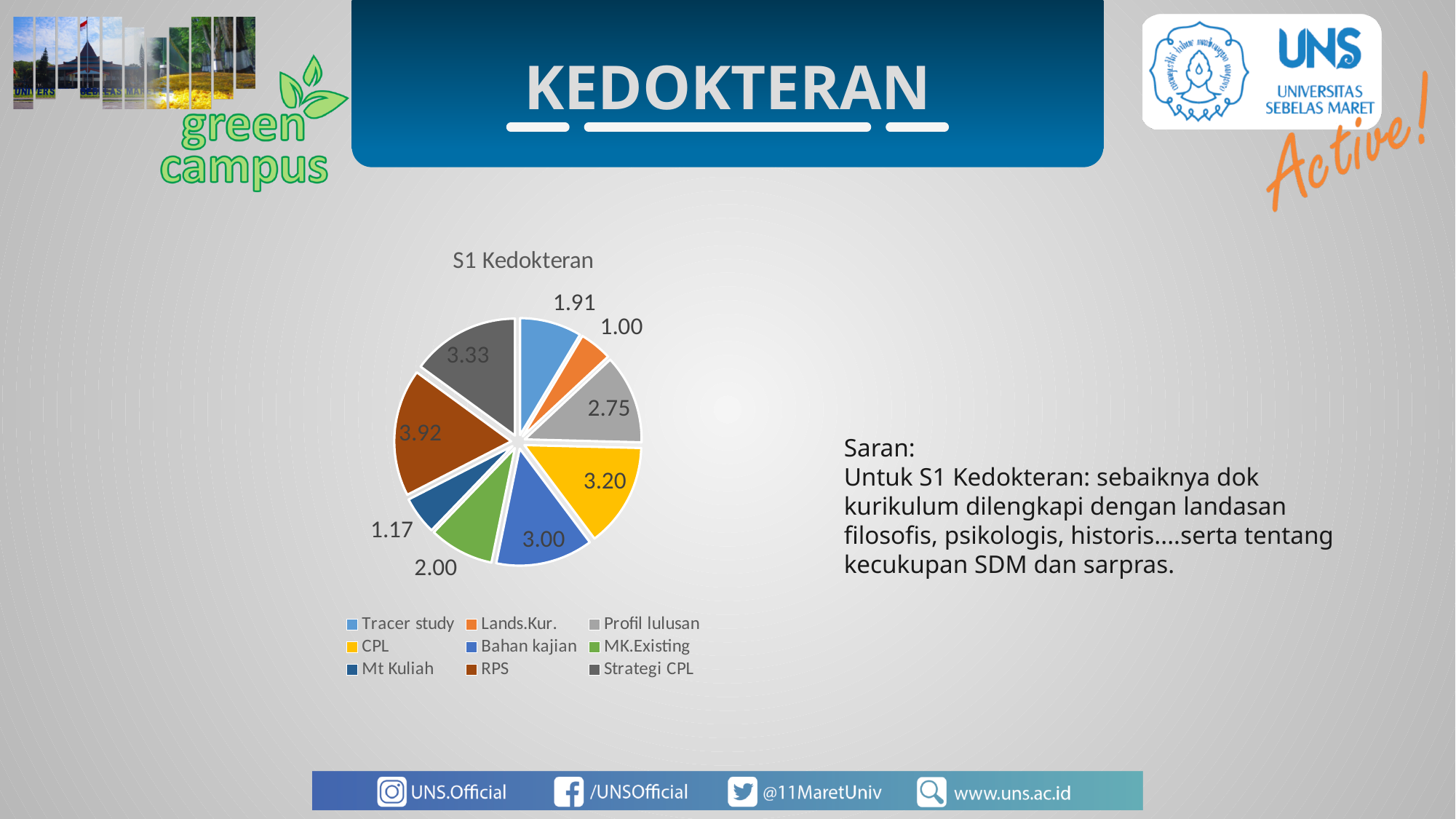
What is the value for Tracer study in the pie chart? 1.91 What is the difference between the values for MK.Existing and Lands.Kur.? 1.00 How many categories does the pie chart have? 9 What is the value for Mt Kuliah in the pie chart? 1.17 What is the value for RPS in the S1 Kedokteran pie chart? 3.92 What is the difference between the values for RPS and Strategi CPL? 0.59 What is the title of the chart? S1 Kedokteran Which category has the smallest slice in the pie chart? Lands.Kur. What type of chart is shown on the slide? pie chart Which is larger, the value for Profil lulusan or the value for Bahan kajian? Bahan kajian What is the value for CPL in the pie chart? 3.20 Which category has the largest slice in the pie chart? RPS